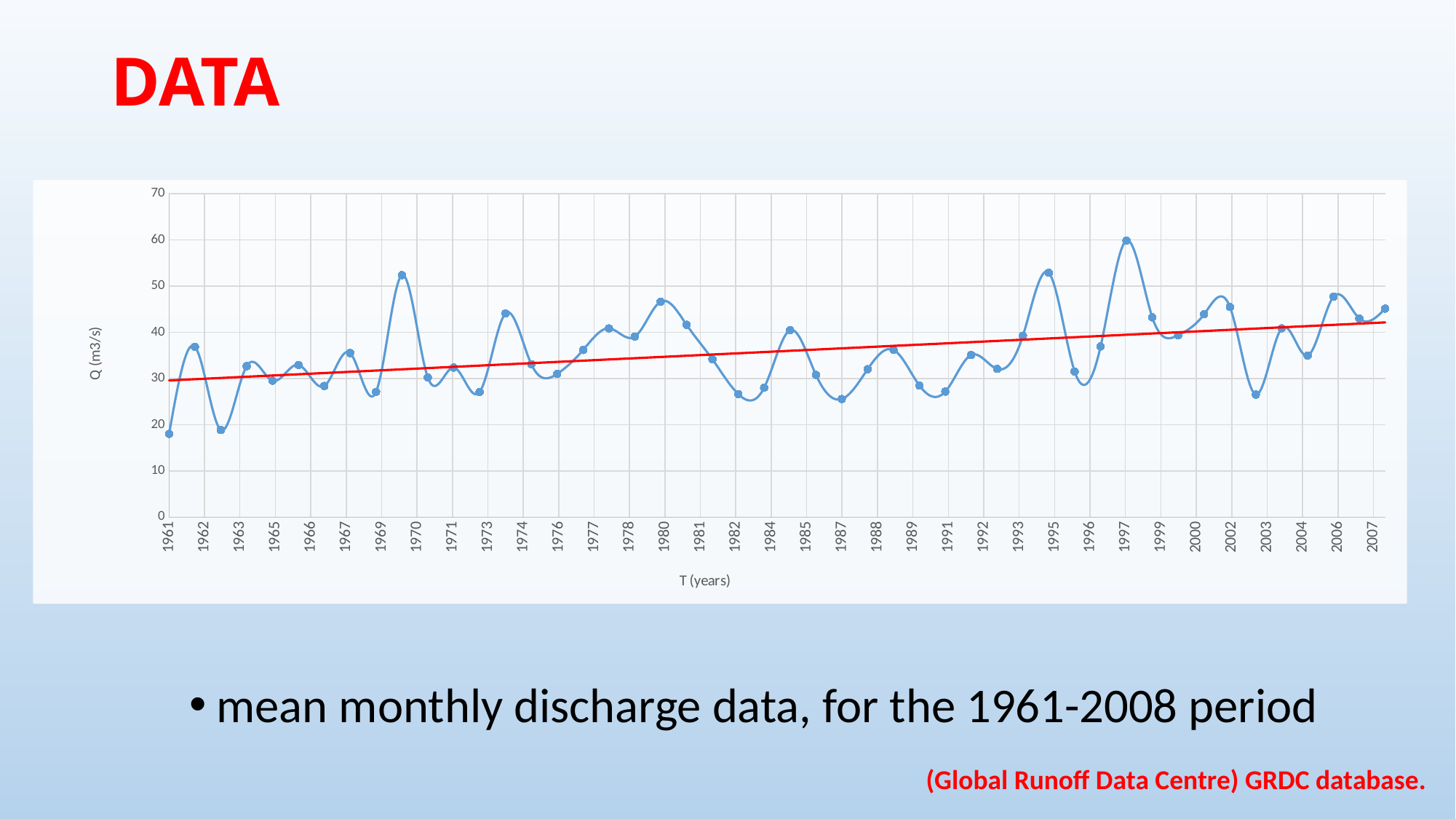
What kind of chart is shown on the slide? line chart Is the value for 1995 greater or less than 50? greater Is the value for 1980 greater or less than 40? greater Is the value for 1987 greater or less than 30? less What is the label of the vertical axis? Q (m3/s) What is the label of the horizontal axis? T (years) In which labelled year does the discharge reach its lowest value? 1961 Does the red trend line rise or fall from left to right across the years? rises